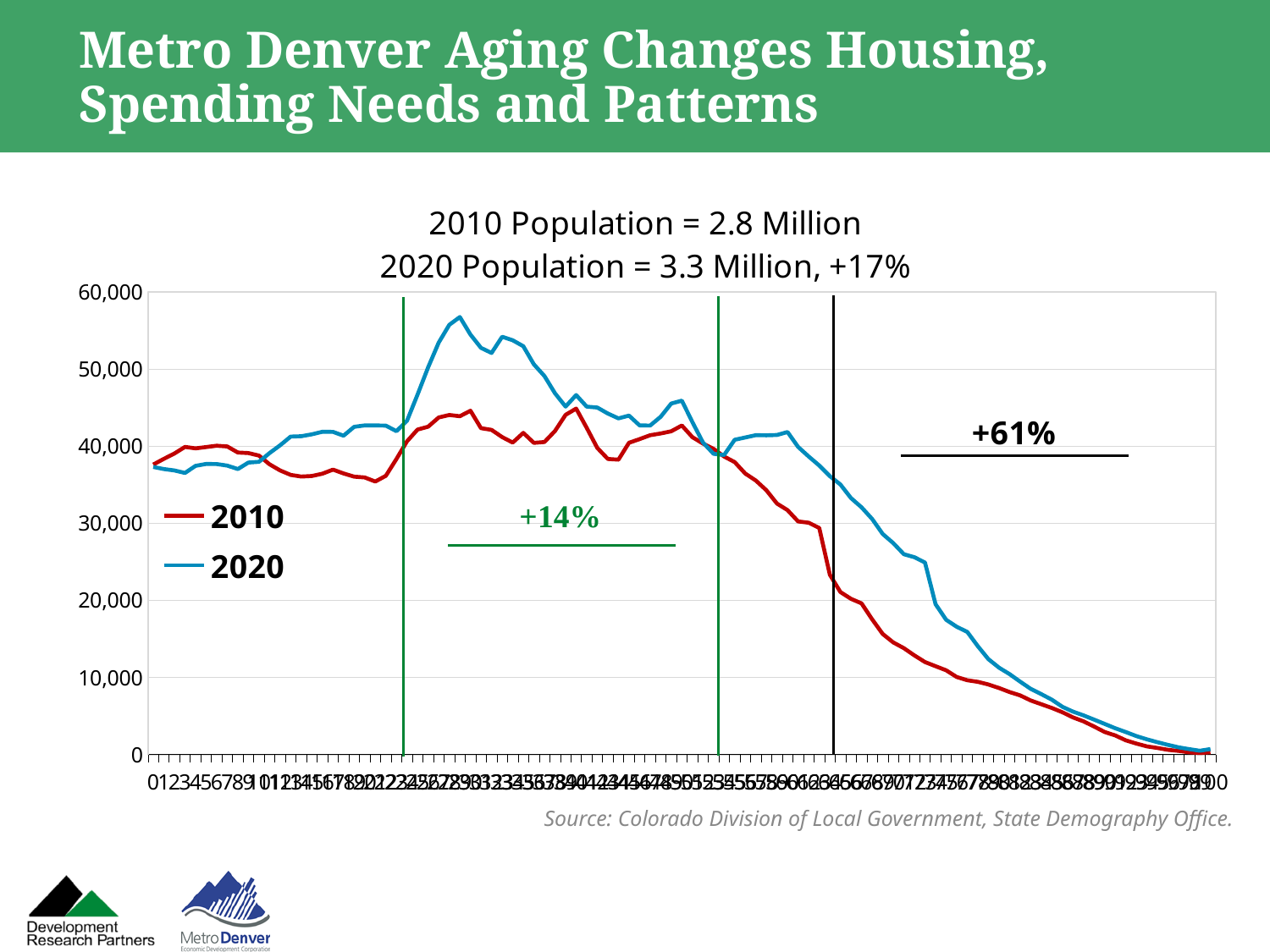
Do the values of both lines rise or fall toward the right end of the x axis? fall What kind of chart is shown on the slide? Line chart What is the highest value shown on the chart's y axis? 60,000 Is the value of the 2020 line at the far right of the x axis greater or less than 10,000? less According to the chart title, what was the 2020 population? 3.3 Million Is the value of the 2010 line at the far left of the x axis greater or less than 30,000? greater Is the highest point of the 2010 line greater or less than 50,000? less Which two series are listed in the chart's legend? 2010 and 2020 Which series reaches the higher peak value, 2010 or 2020? 2020 How many series does the chart's legend list? 2